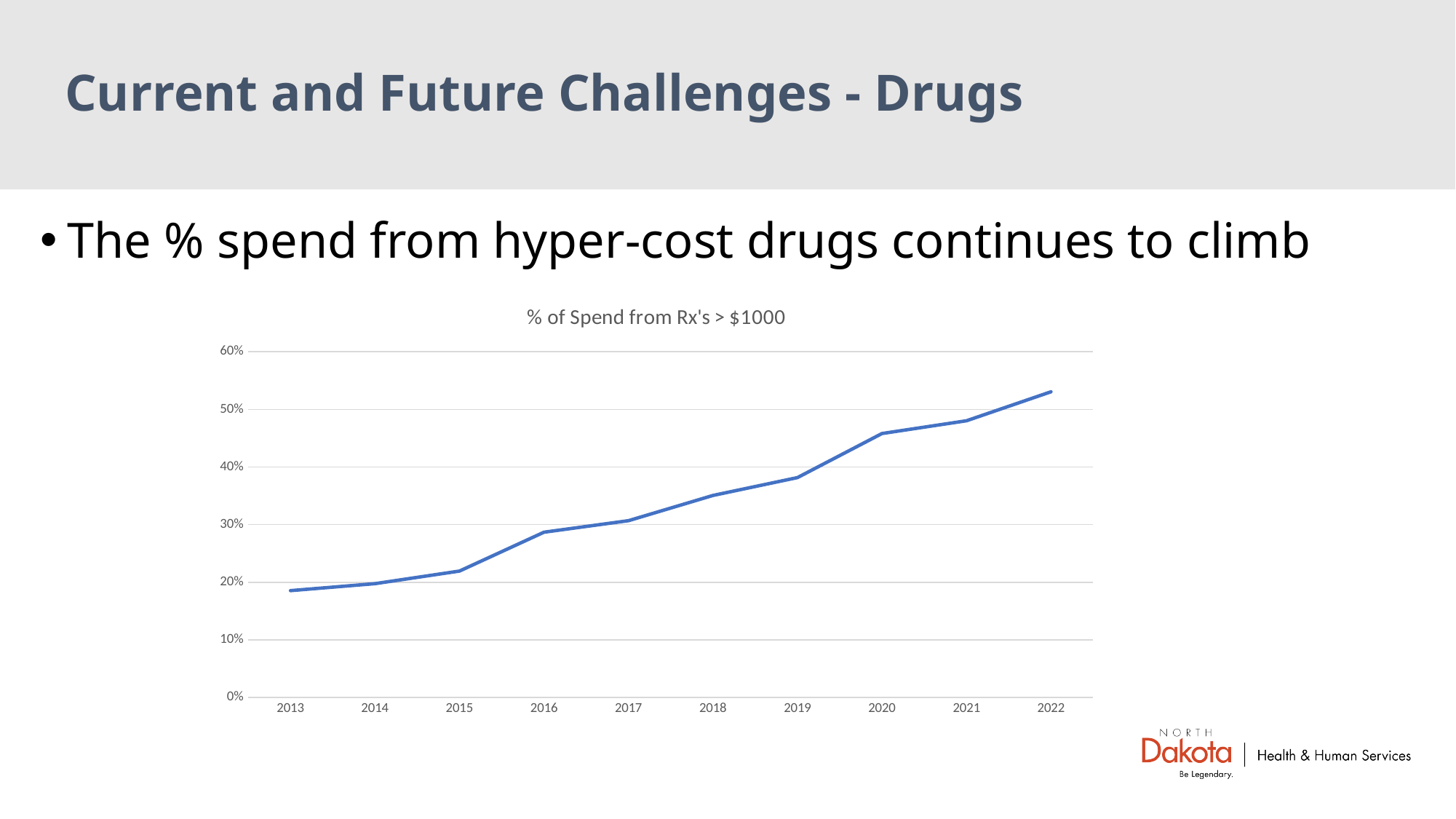
Which year has the highest % of spend from Rx's > $1000? 2022 How many years are plotted on the x axis of the chart? 10 Is the value for 2015 greater or less than 30%? less What is the title of the chart? % of Spend from Rx's > $1000 Which year has the lowest % of spend from Rx's > $1000? 2013 Is the value for 2020 greater or less than 40%? greater Which year has a larger value, 2016 or 2020? 2020 Is the value for 2013 greater or less than 20%? less Does the % of spend from Rx's > $1000 rise or fall from 2013 to 2022? rise What kind of chart is shown on the slide? line chart